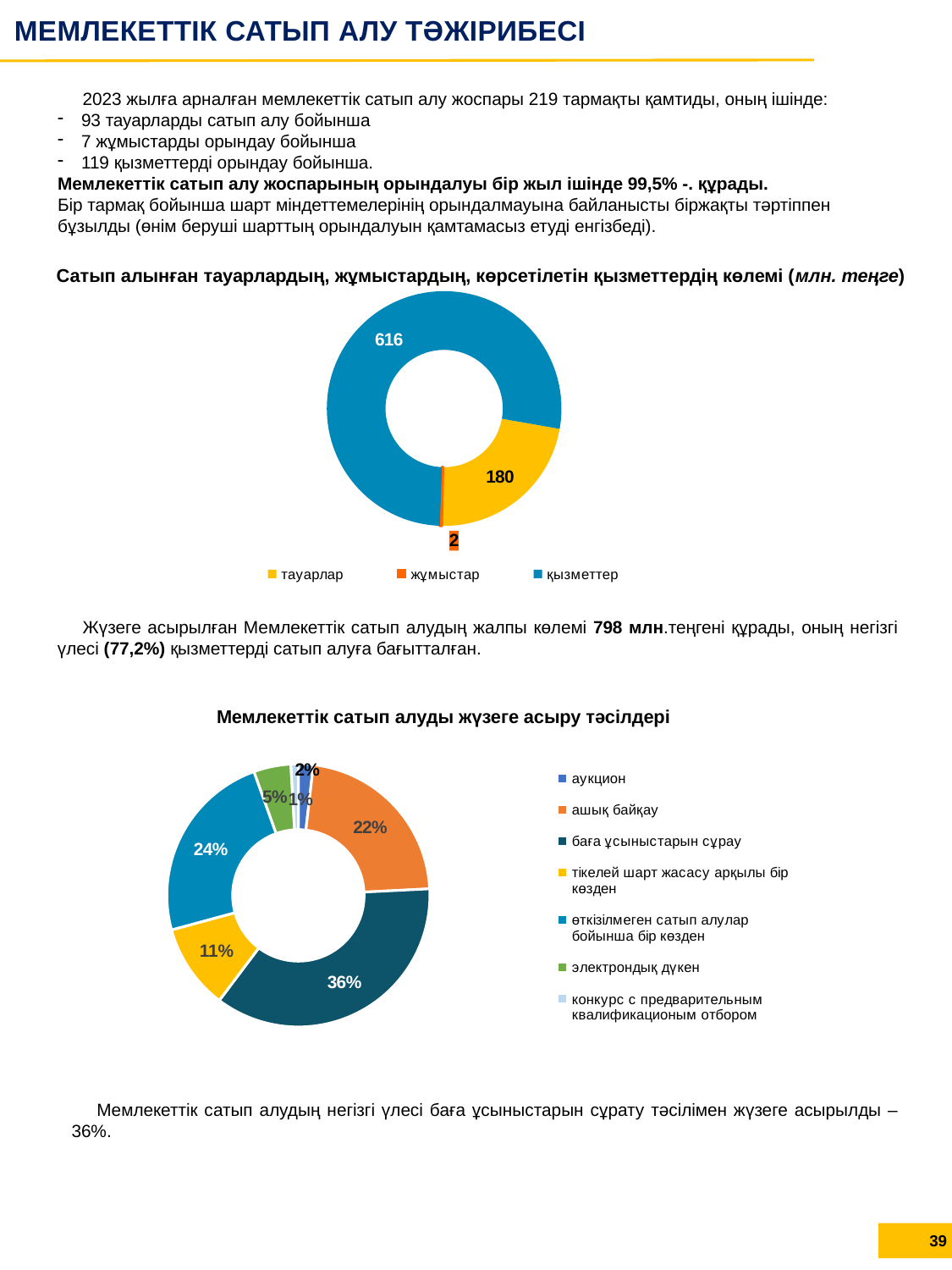
What kind of chart is the chart titled 'Мемлекеттік сатып алуды жүзеге асыру тәсілдері'? Doughnut chart In the chart titled 'Сатып алынған тауарлардың, жұмыстардың, көрсетілетін қызметтердің көлемі (млн. теңге)', what is the value for тауарлар? 180 In the chart titled 'Сатып алынған тауарлардың, жұмыстардың, көрсетілетін қызметтердің көлемі (млн. теңге)', what is the difference between the values for қызметтер and тауарлар? 436 In the chart titled 'Мемлекеттік сатып алуды жүзеге асыру тәсілдері', how many categories does the legend list? 7 In the chart titled 'Мемлекеттік сатып алуды жүзеге асыру тәсілдері', which is larger: өткізілмеген сатып алулар бойынша бір көзден or тікелей шарт жасасу арқылы бір көзден? өткізілмеген сатып алулар бойынша бір көзден In the chart titled 'Мемлекеттік сатып алуды жүзеге асыру тәсілдері', what is the share for ашық байқау? 22% In the chart titled 'Сатып алынған тауарлардың, жұмыстардың, көрсетілетін қызметтердің көлемі (млн. теңге)', which category has the largest value? қызметтер In the chart titled 'Сатып алынған тауарлардың, жұмыстардың, көрсетілетін қызметтердің көлемі (млн. теңге)', which category has the smallest value? жұмыстар In the chart titled 'Сатып алынған тауарлардың, жұмыстардың, көрсетілетін қызметтердің көлемі (млн. теңге)', what is the value for жұмыстар? 2 In the chart titled 'Сатып алынған тауарлардың, жұмыстардың, көрсетілетін қызметтердің көлемі (млн. теңге)', how many categories does the legend list? 3 In the chart titled 'Мемлекеттік сатып алуды жүзеге асыру тәсілдері', what is the share for баға ұсыныстарын сұрау? 36% In the chart titled 'Сатып алынған тауарлардың, жұмыстардың, көрсетілетін қызметтердің көлемі (млн. теңге)', what is the value for қызметтер? 616